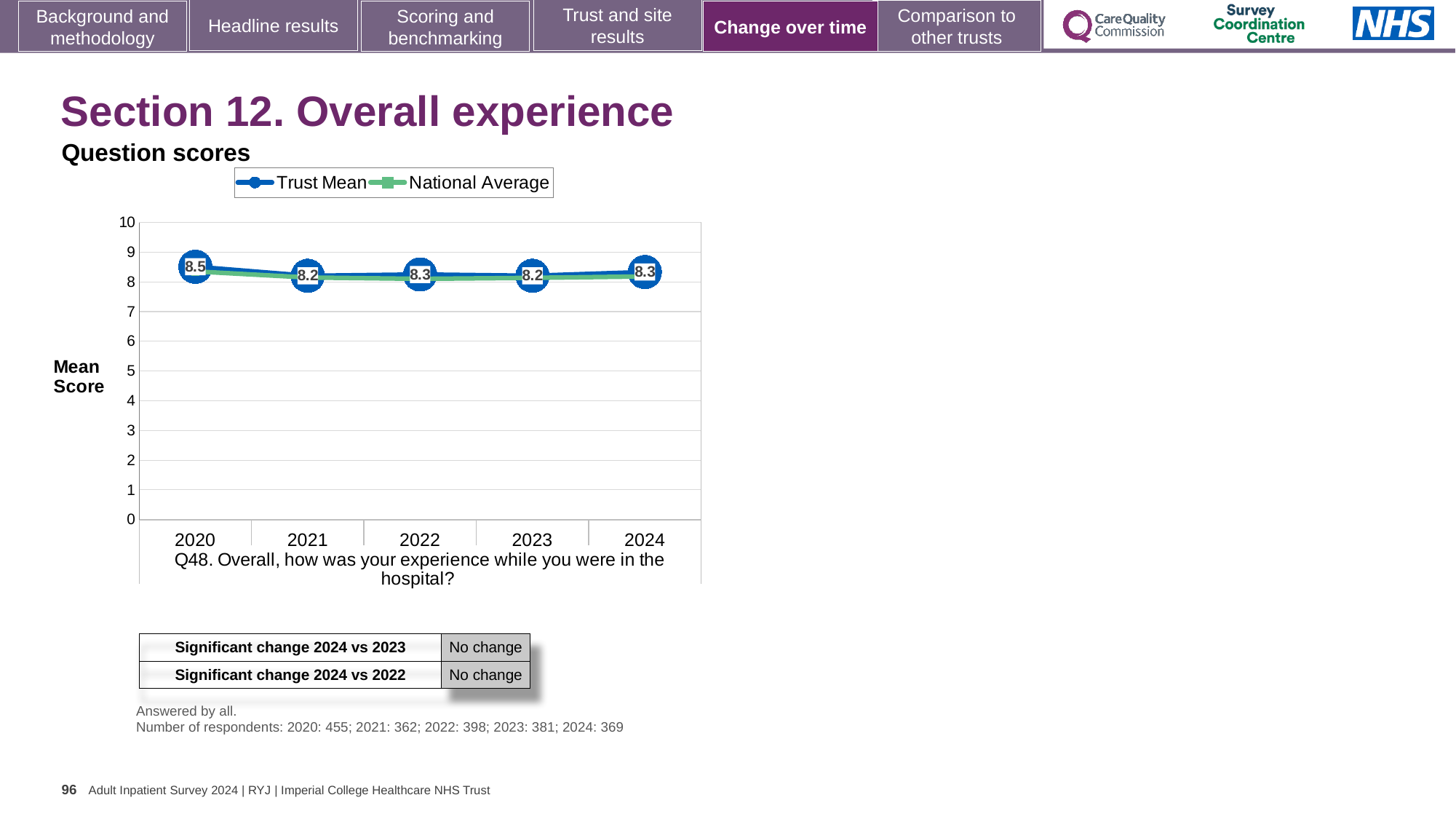
What is the Trust Mean score for 2024? 8.3 What is the Trust Mean score for 2020? 8.5 In which year is the Trust Mean score highest? 2020 What is the difference between the Trust Mean scores for 2020 and 2021? 0.3 Does the Trust Mean score rise or fall from 2020 to 2024? Fall Which year has the larger Trust Mean score, 2020 or 2023? 2020 What is the Trust Mean score for 2021? 8.2 What kind of chart is shown on the slide? Line chart What is the label on the y axis of the chart? Mean Score How many series does the legend list? 2 How many years are plotted on the x axis? 5 Is the National Average value for 2020 greater or less than 8? greater